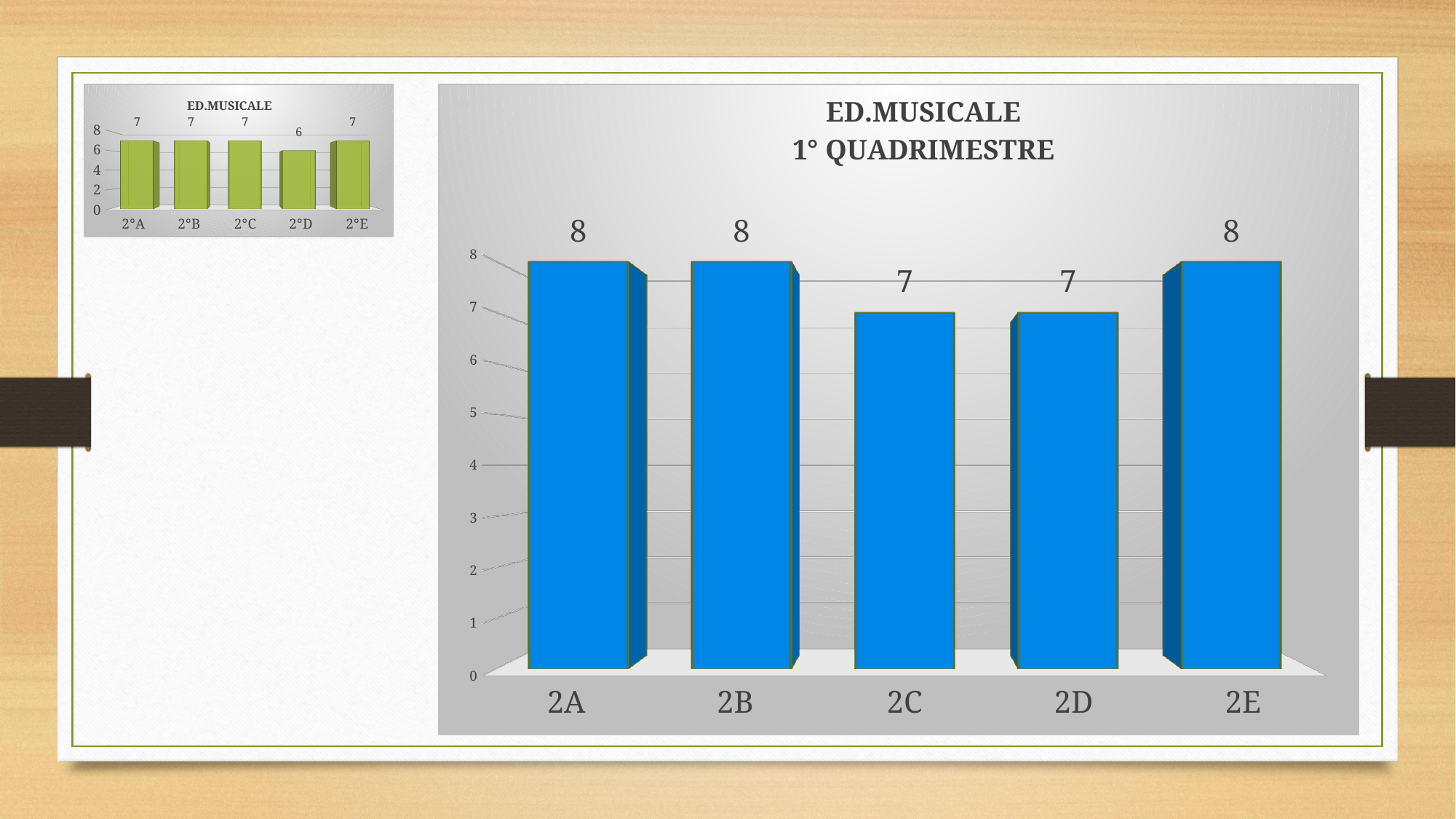
What kind of chart is the large chart titled 'ED.MUSICALE 1° QUADRIMESTRE'? bar chart What colour are the bars in the large chart titled 'ED.MUSICALE 1° QUADRIMESTRE'? blue In the large chart titled 'ED.MUSICALE 1° QUADRIMESTRE', what is the value for 2E? 8 In the small chart at the top left titled 'ED.MUSICALE', what is the difference between the values for 2°C and 2°D? 1 In the large chart titled 'ED.MUSICALE 1° QUADRIMESTRE', how many categories are shown on the x axis? 5 In the large chart titled 'ED.MUSICALE 1° QUADRIMESTRE', which is larger, the value for 2B or the value for 2C? 2B In the large chart titled 'ED.MUSICALE 1° QUADRIMESTRE', what is the value for 2C? 7 In the small chart at the top left titled 'ED.MUSICALE', which category has the lowest value? 2°D In the small chart at the top left titled 'ED.MUSICALE', what is the value for 2°D? 6 In the small chart at the top left titled 'ED.MUSICALE', what is the value for 2°A? 7 In the large chart titled 'ED.MUSICALE 1° QUADRIMESTRE', which categories have the lowest value? 2C and 2D In the large chart titled 'ED.MUSICALE 1° QUADRIMESTRE', what is the difference between the values for 2A and 2D? 1